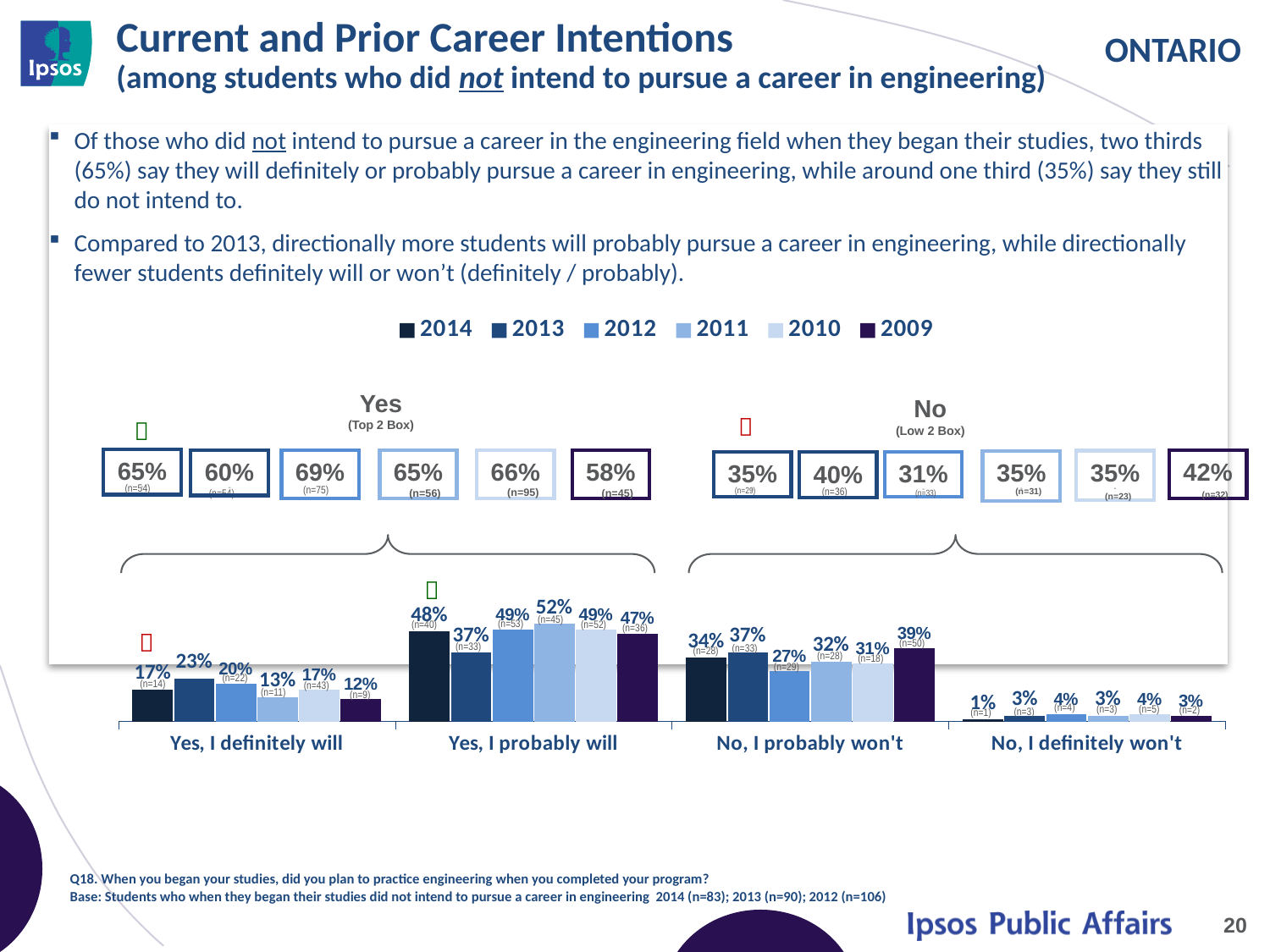
Which year has the lowest value for "Yes, I definitely will"? 2009 Which is larger for "No, I probably won't": the 2014 value or the 2012 value? 2014 Which year has the highest value for "Yes, I probably will"? 2011 What is the 2009 value for "No, I probably won't"? 39% How many series does the legend list? 6 What kind of chart is shown on the slide? Bar chart How many response categories are shown on the x axis? 4 What is the 2013 value for "Yes, I definitely will"? 23% What is the 2014 value for "Yes, I probably will"? 48% What is the difference between the 2014 and 2013 values for "Yes, I probably will"? 11% What is the 2014 value for "No, I definitely won't"? 1% What is the 2014 "Yes (Top 2 Box)" value shown above the chart? 65%